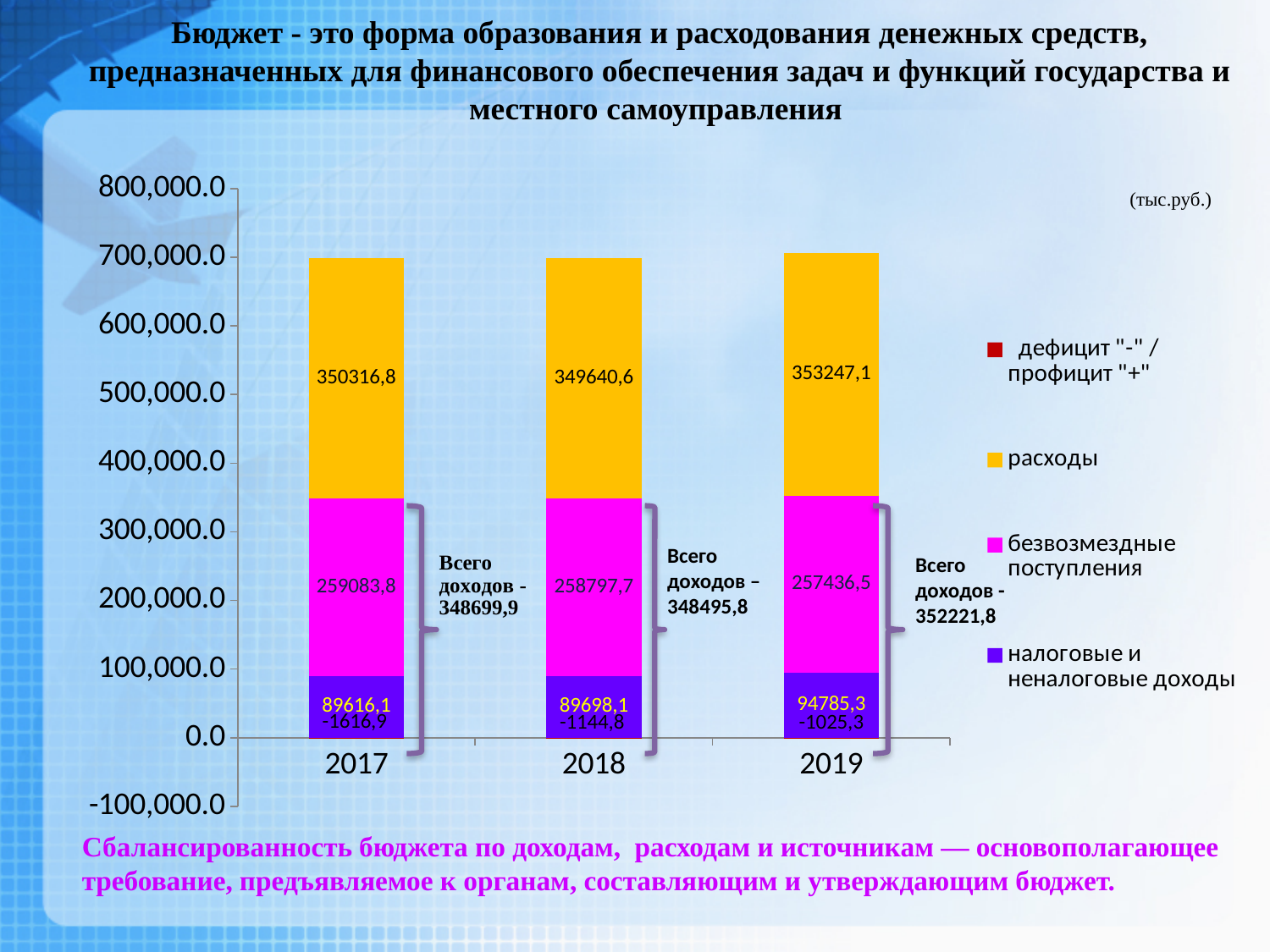
What is the difference between налоговые и неналоговые доходы in 2019 and in 2018? 5087,2 What is the value of безвозмездные поступления for 2018? 258797,7 What is the total income (Всего доходов) shown for 2019? 352221,8 In which year is the value of расходы the lowest? 2018 Which is larger: безвозмездные поступления in 2017 or in 2019? 2017 How many years (categories) are shown on the x axis? 3 How many series does the legend list? 4 What is the value of расходы for 2019? 353247,1 What is the value of дефицит/профицит for 2019? -1025,3 What type of chart is shown on the slide? stacked bar chart What is the value of налоговые и неналоговые доходы for 2017? 89616,1 In which year is the value of налоговые и неналоговые доходы the highest? 2019